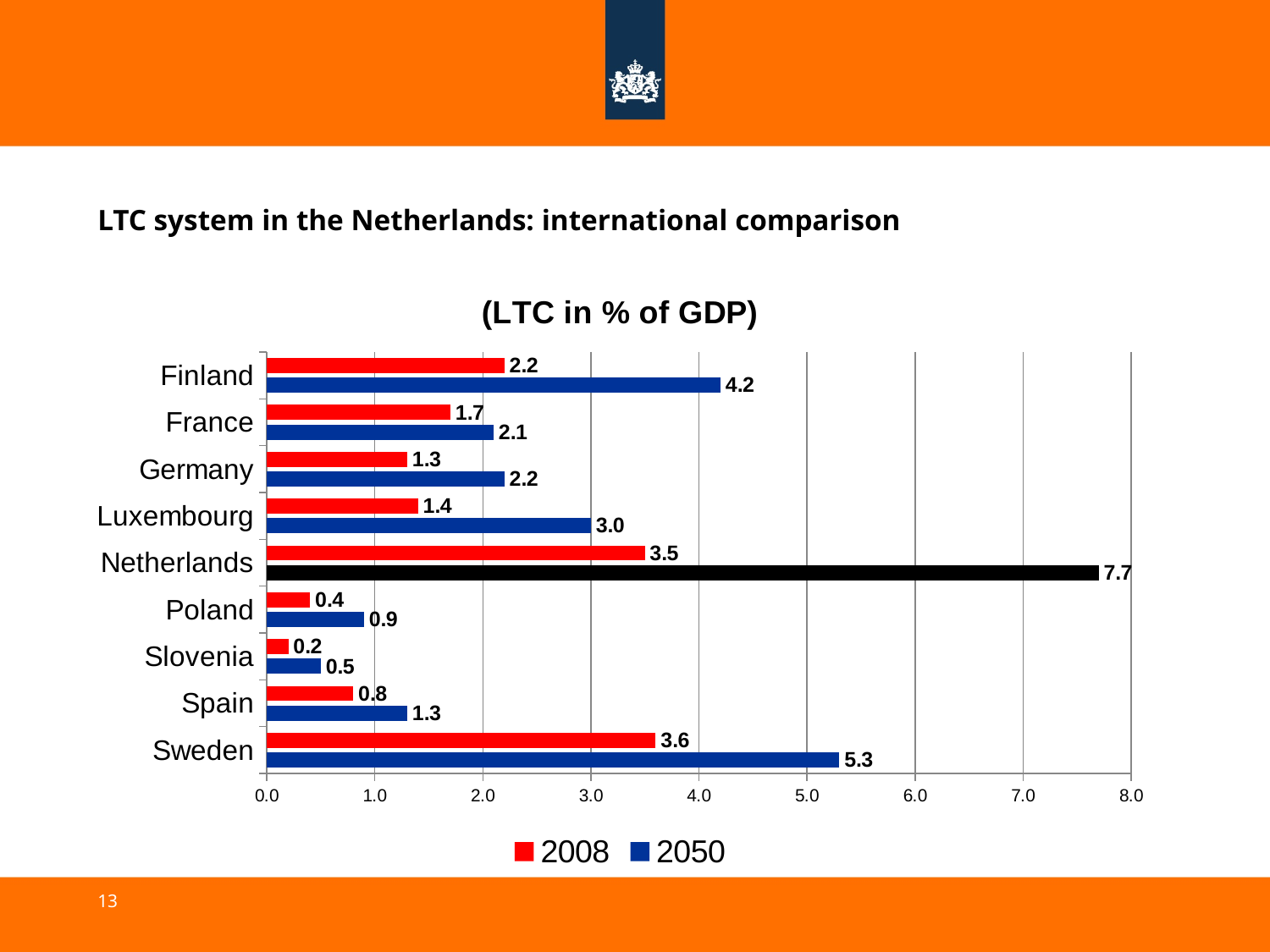
What is the 2008 value for Sweden? 3.6 Which country has the lowest 2008 value? Slovenia What kind of chart is shown on the slide? Bar chart Which country has the highest 2050 value? Netherlands What is the difference between the 2050 and 2008 values for Finland? 2.0 What is the title of the chart? (LTC in % of GDP) Is the 2050 value for Sweden greater or less than 5.0? greater What is the 2050 value for Luxembourg? 3.0 How many series does the legend list? 2 Which is larger: the 2008 value for Sweden or the 2008 value for the Netherlands? Sweden How many countries are shown on the chart? 9 What is the 2050 value for the Netherlands? 7.7